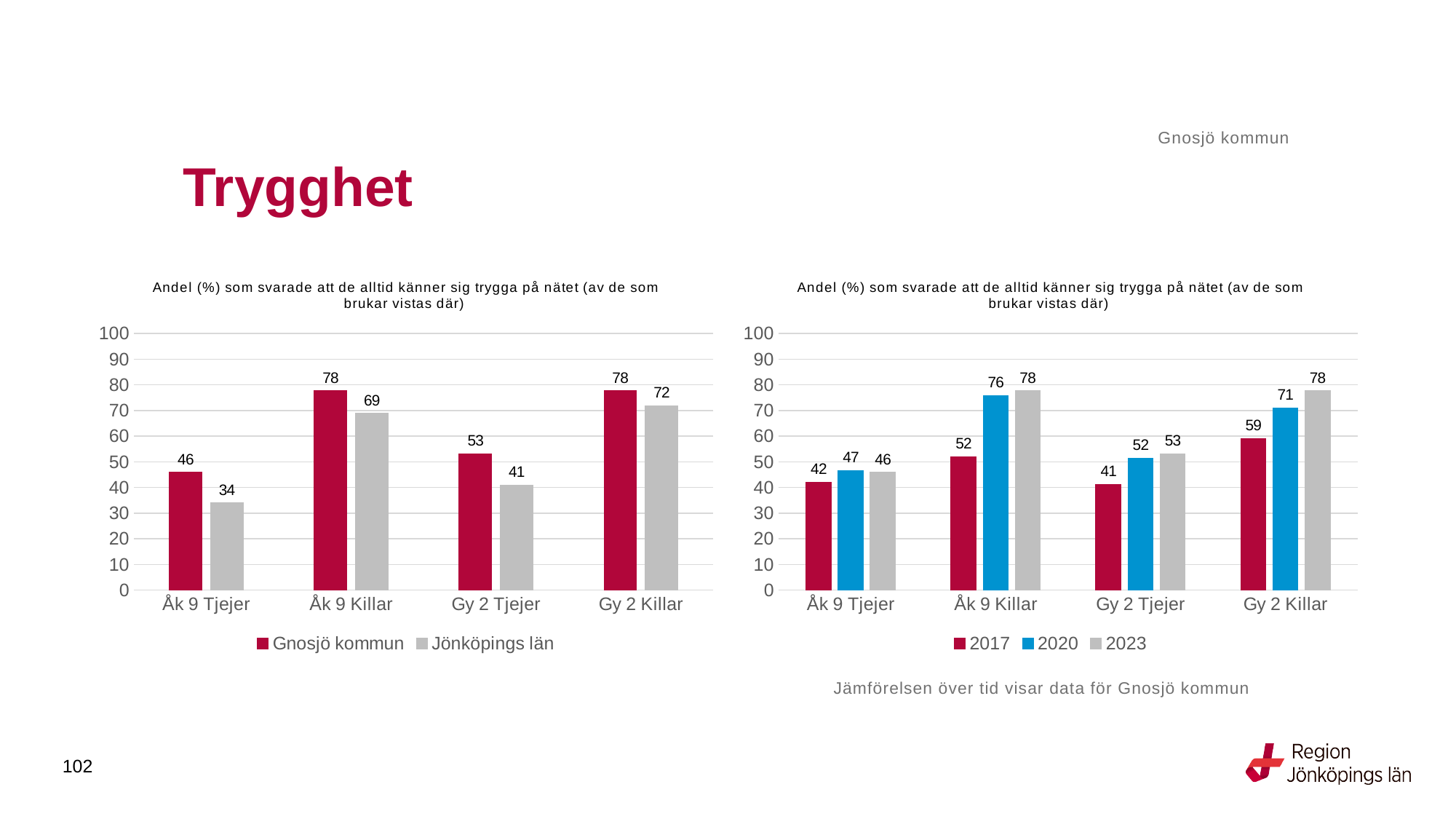
In the right chart, what is the difference between the 2023 and 2017 values for Åk 9 Killar? 26 In the left chart, which category has the lowest value for Jönköpings län? Åk 9 Tjejer In the right chart, which is larger for Gy 2 Killar: the 2020 value or the 2023 value? 2023 In the left chart, how many series does the legend list? 2 In the right chart, which category has the lowest value for 2017? Gy 2 Tjejer In the right chart, what is the value for 2020 for Åk 9 Killar? 76 In the right chart, what is the value for 2017 for Gy 2 Killar? 59 In the right chart, how many categories are shown on the x axis? 4 In the left chart, what is the difference between Gnosjö kommun and Jönköpings län for Åk 9 Tjejer? 12 In the left chart, what is the value for Jönköpings län for Gy 2 Tjejer? 41 What kind of chart is the right chart? Bar chart In the left chart, what is the value for Gnosjö kommun for Åk 9 Tjejer? 46